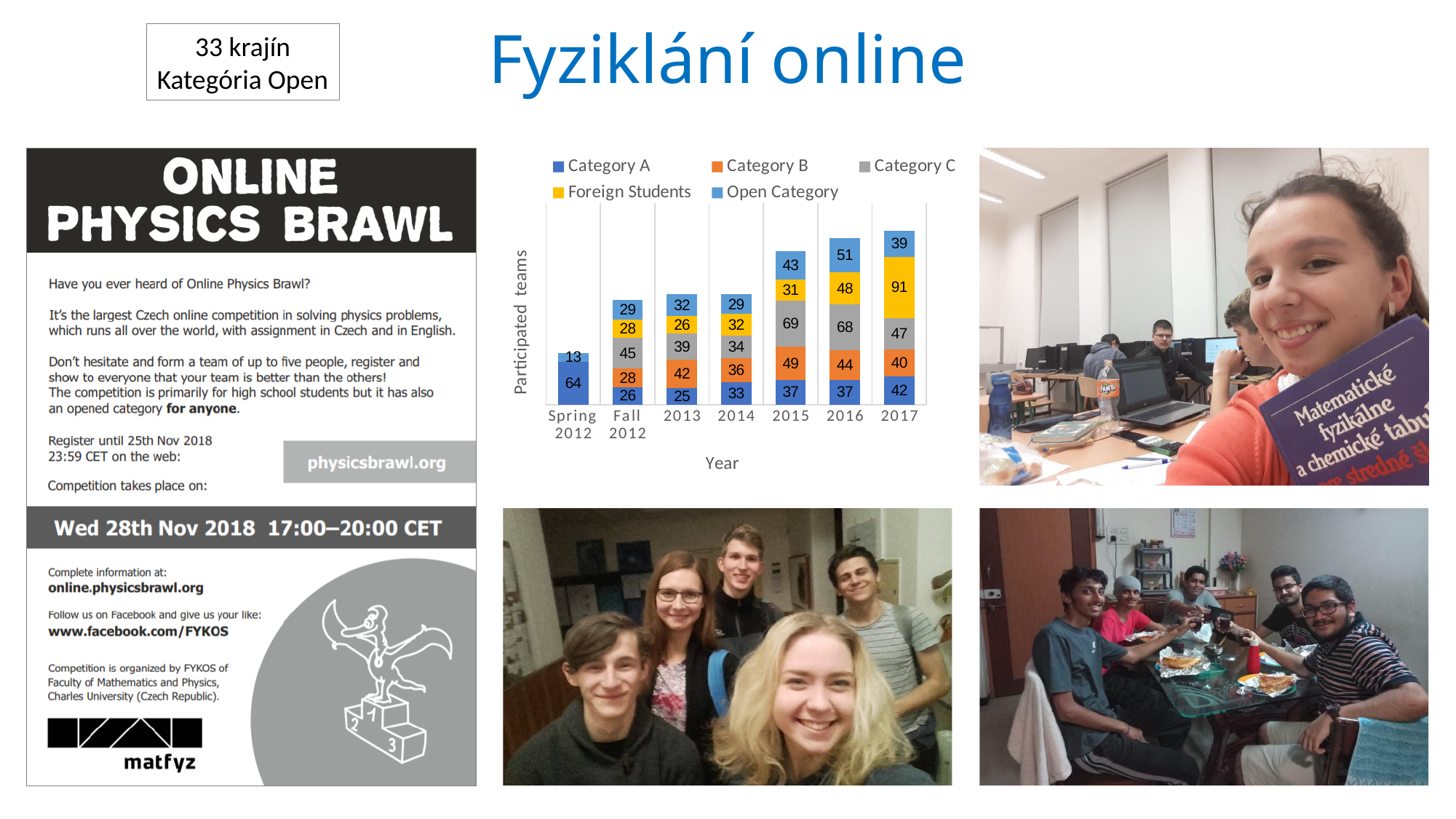
How many year categories are shown on the x axis of the chart? 7 How many Foreign Students teams participated in 2017? 91 What is the total number of participated teams in 2017 across all categories? 259 In which year is the Foreign Students value highest? 2017 What is the Category C value for 2015? 69 Which is larger, the Category B value for 2015 or for 2016? 2015 What is the label of the y axis of the chart? Participated teams How many series does the chart legend list? 5 In which year is the Category A value lowest? 2013 What is the difference between the Open Category values for 2016 and 2017? 12 What kind of chart is shown on the slide? Stacked bar chart What is the Category A value for Spring 2012? 64